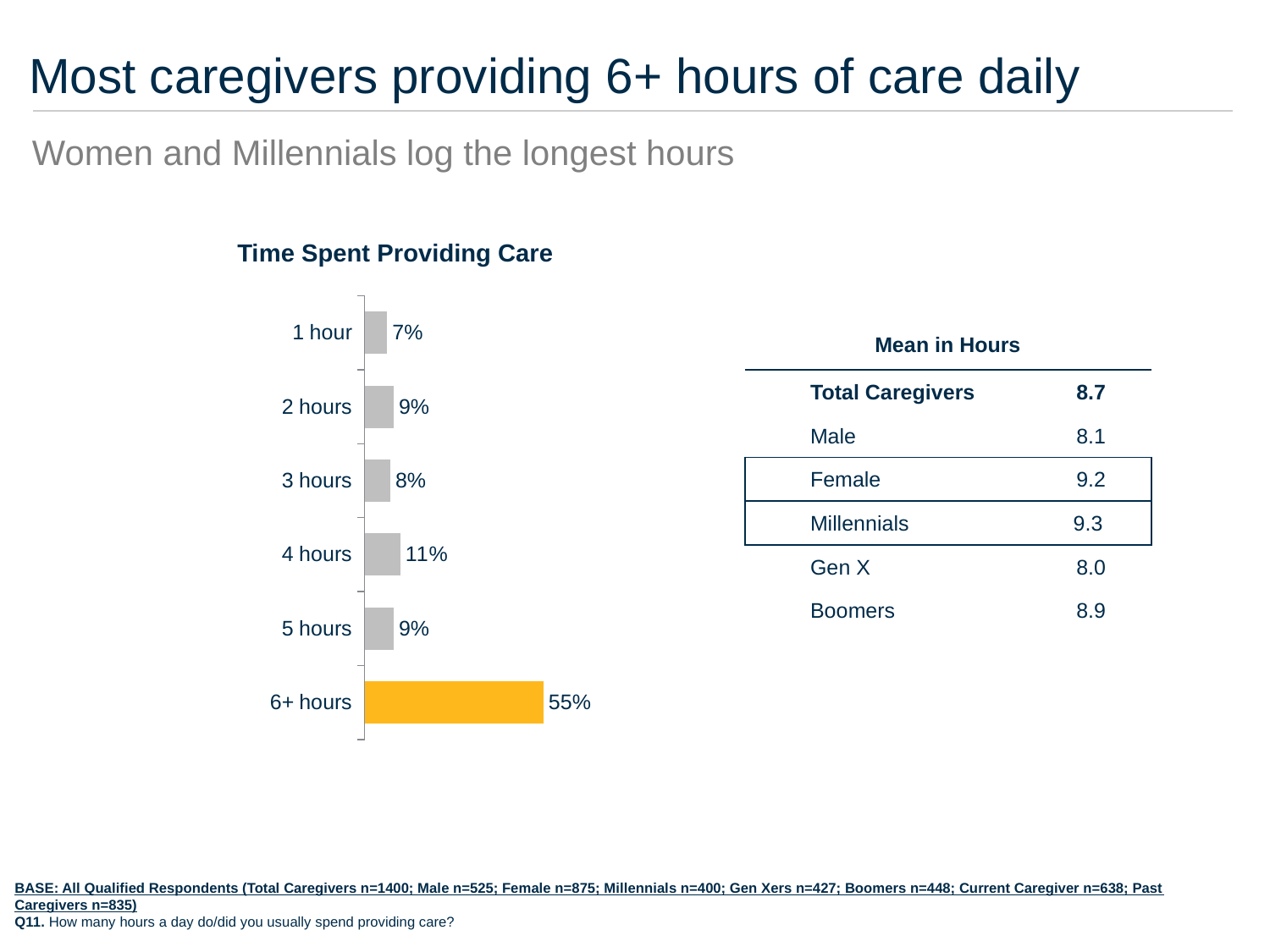
What percentage of caregivers spend 6+ hours providing care? 55% Which time category has the lowest percentage in the Time Spent Providing Care chart? 1 hour Which has a higher percentage: 3 hours or 4 hours? 4 hours What is the difference in percentage points between the 6+ hours category and the 4 hours category? 44 What is the title of the chart on the slide? Time Spent Providing Care Which bar in the Time Spent Providing Care chart is highlighted in a different colour (yellow) from the others? 6+ hours What type of chart is the Time Spent Providing Care chart? Bar chart Which time category has the highest percentage in the Time Spent Providing Care chart? 6+ hours How many time categories are shown in the Time Spent Providing Care chart? 6 What percentage of caregivers spend 1 hour providing care? 7% What percentage of caregivers spend 4 hours providing care? 11% What is the combined percentage of caregivers spending 2 hours and 5 hours providing care? 18%